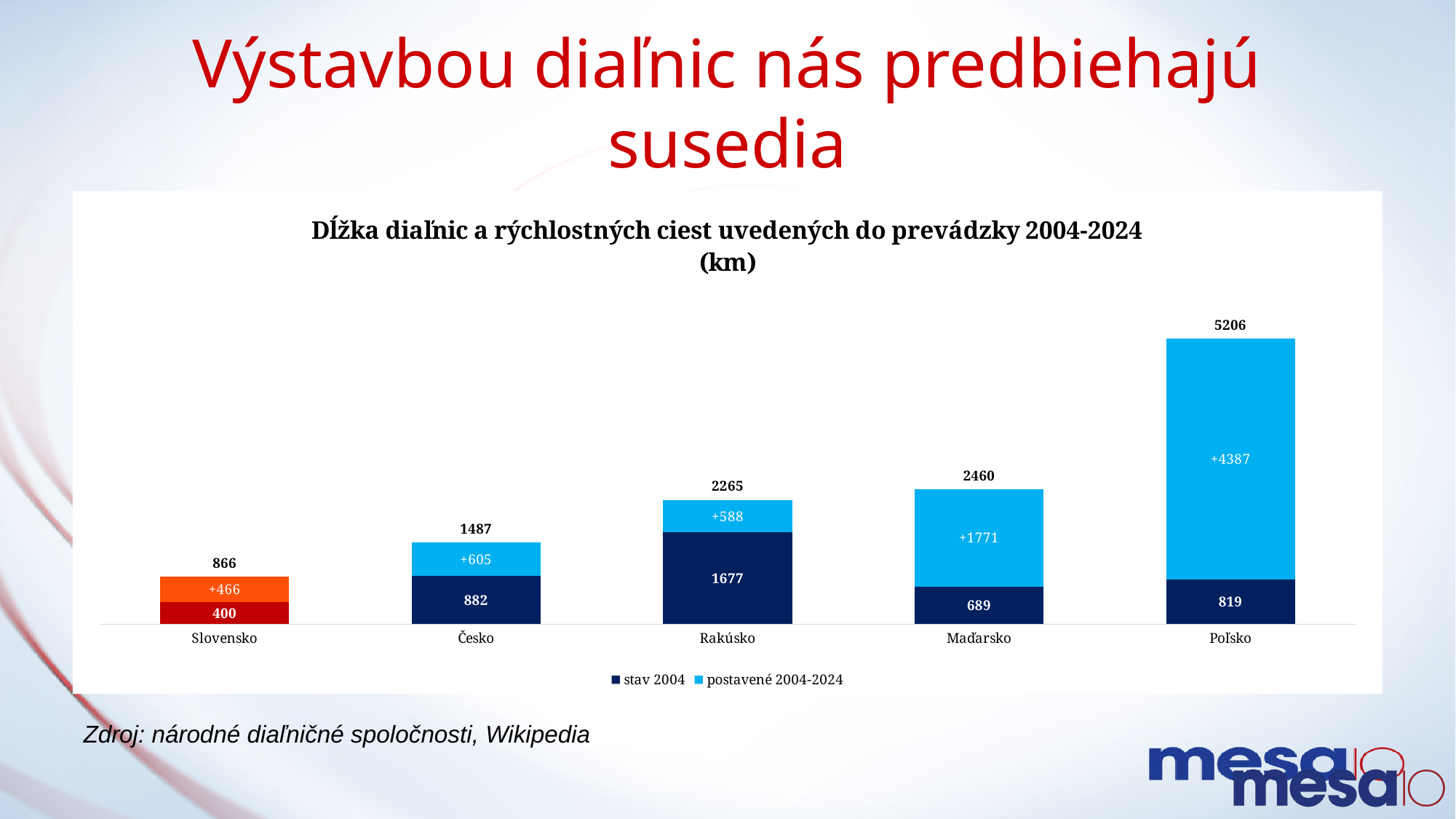
Which country has the lowest total bar? Slovensko Which country has the highest total bar? Poľsko What is the title of the chart? Dĺžka diaľnic a rýchlostných ciest uvedených do prevádzky 2004-2024 (km) What is the 'postavené 2004-2024' value for Slovensko? +466 How many countries are shown on the x axis? 5 What is the 'postavené 2004-2024' value for Poľsko? +4387 Which is larger: the 'stav 2004' value for Česko or for Maďarsko? Česko What is the difference between the total for Česko and the total for Slovensko? 621 What kind of chart is shown on the slide? Stacked bar chart What is the 'stav 2004' value for Rakúsko? 1677 What is the total shown above the bar for Maďarsko? 2460 How many series does the legend list? 2